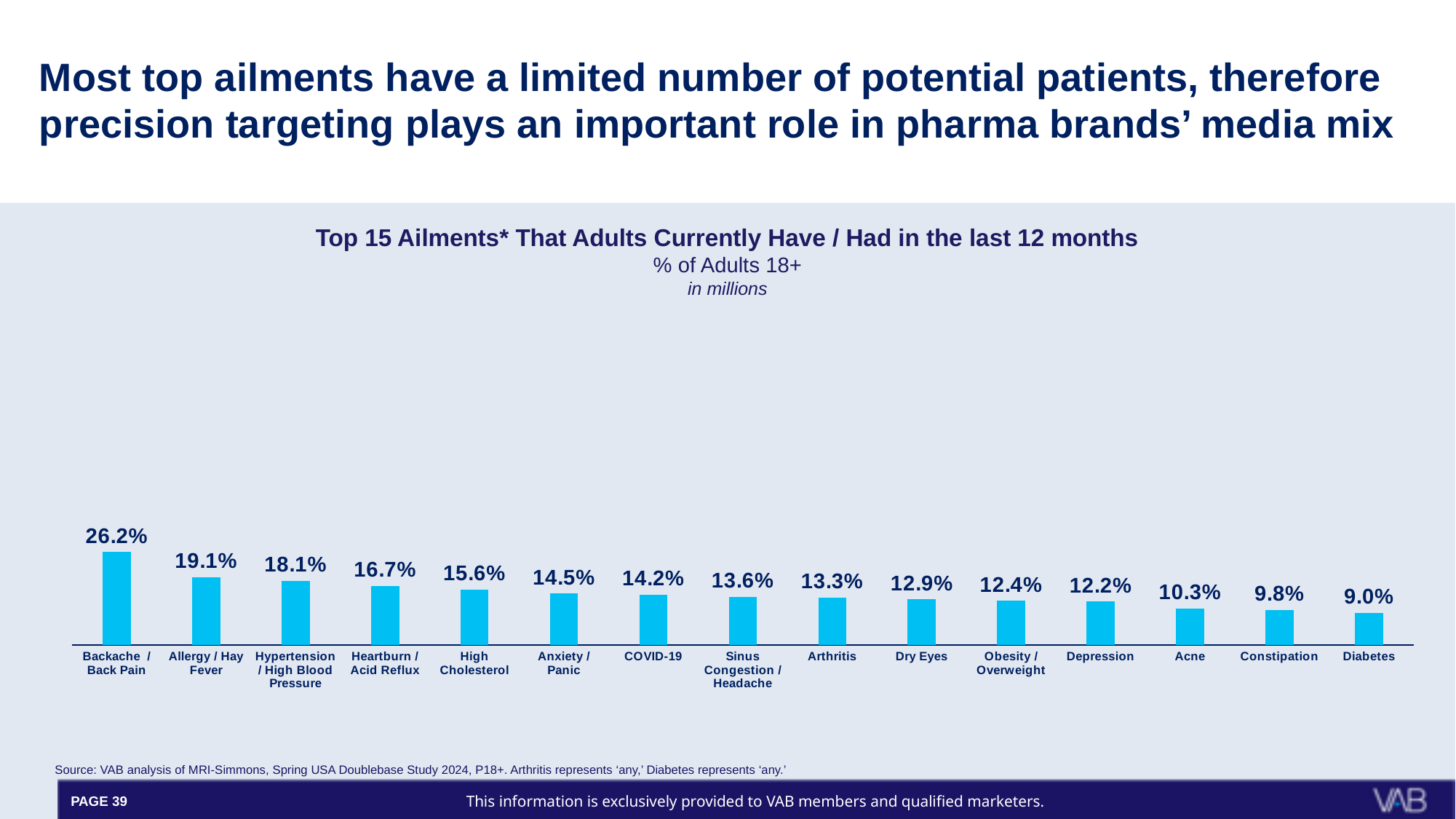
What percentage of adults 18+ currently have or had Backache / Back Pain in the last 12 months? 26.2% Which is larger, the value for Arthritis or the value for Depression? Arthritis What kind of chart is shown on the slide? Bar chart How many ailments are shown in the chart? 15 What is the difference between the values for Backache / Back Pain and Diabetes? 17.2% Which ailment has the highest percentage of adults? Backache / Back Pain What is the title of the chart? Top 15 Ailments* That Adults Currently Have / Had in the last 12 months What is the difference between the values for Allergy / Hay Fever and Acne? 8.8% What is the value shown for Obesity / Overweight? 12.4% Do the values rise or fall from left to right across the chart? Fall What is the value shown for COVID-19? 14.2% Which ailment has the lowest percentage of adults? Diabetes